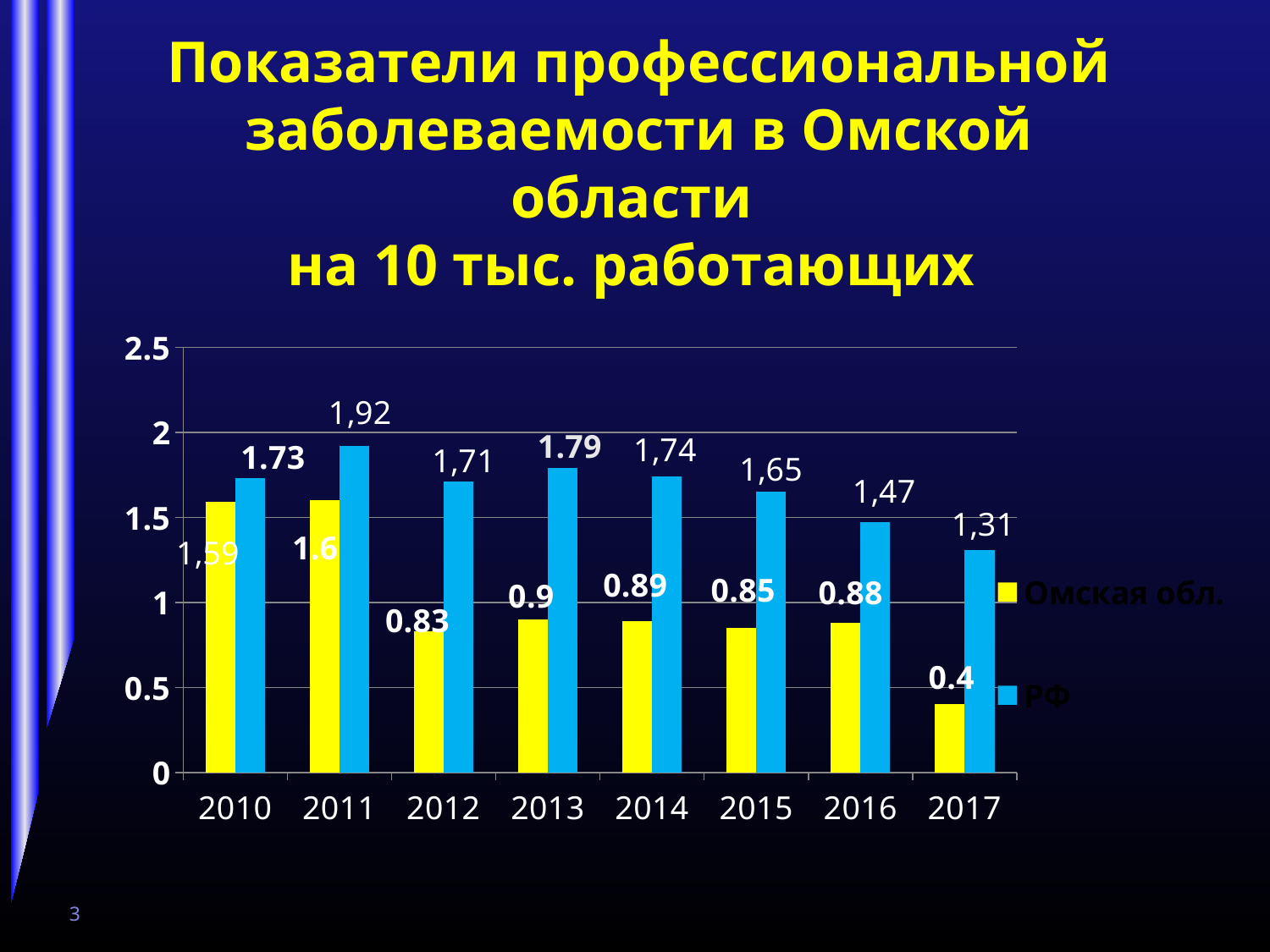
What is the value for Омская обл. in 2012? 0.83 In which year is the РФ value highest? 2011 How many series does the legend list? 2 In which year is the Омская обл. value lowest? 2017 What is the value for РФ in 2011? 1,92 Which is larger in 2014, the value for Омская обл. or for РФ? РФ What is the value for РФ in 2016? 1,47 Do the РФ values rise or fall from 2011 to 2017? fall What is the value for Омская обл. in 2017? 0.4 What is the difference between the РФ and Омская обл. values in 2017? 0.91 How many years are shown on the x axis? 8 In which year is the РФ value lowest? 2017